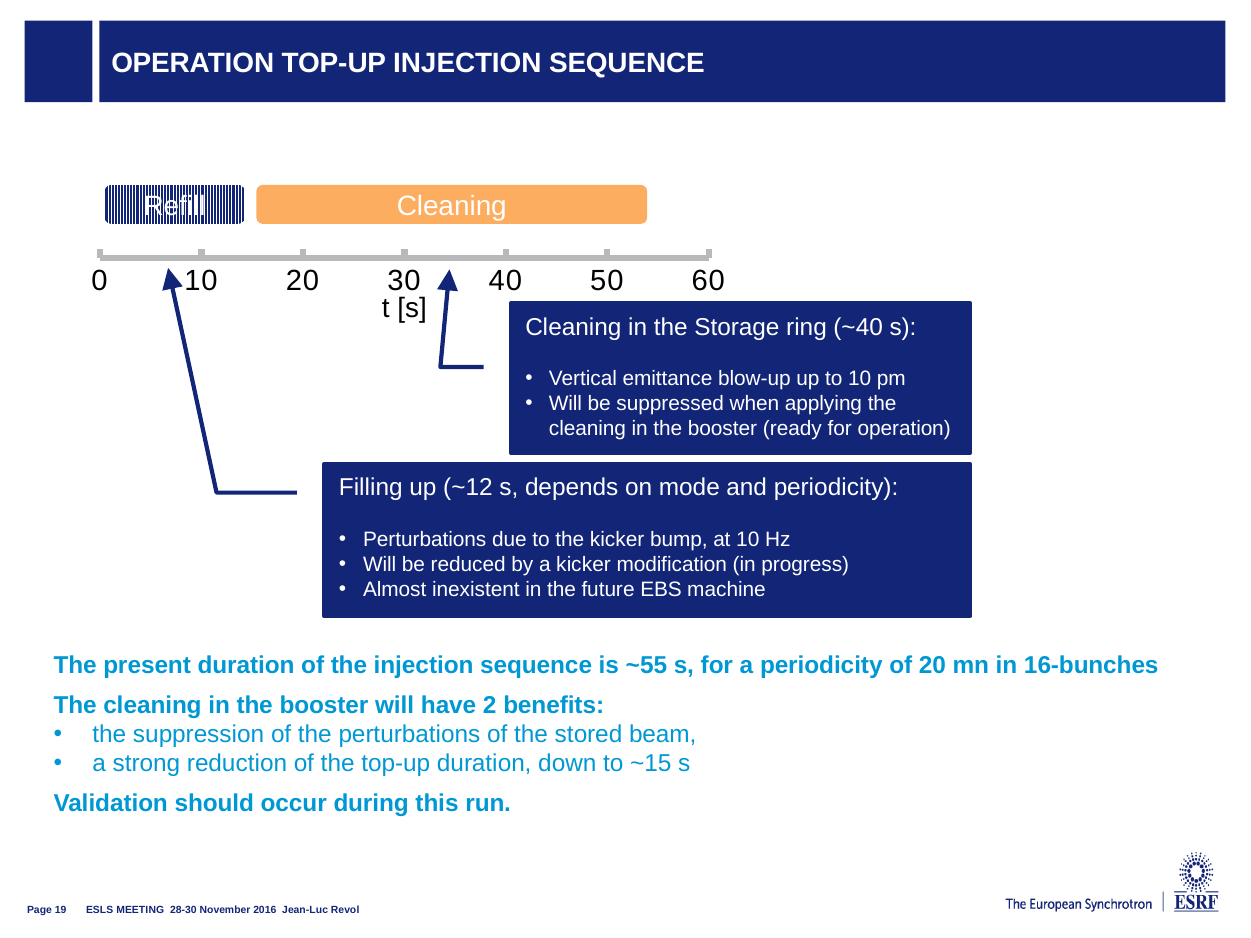
What is the spacing between consecutive ticks on the time axis? 10 What is the highest tick value shown on the time axis? 60 Is the end of the Refill segment greater or less than 20 s? less Is the start of the Cleaning segment greater or less than 10 s? greater What kind of chart is shown on the slide? A horizontal bar (timeline) chart Is the end of the Cleaning segment greater or less than 60 s? less What is the label of the horizontal axis? t [s] Which segment is longer, Refill or Cleaning? Cleaning Which segment comes first along the time axis? Refill How many segments (phases) are plotted on the timeline? 2 What are the labels of the two segments on the timeline? Refill and Cleaning